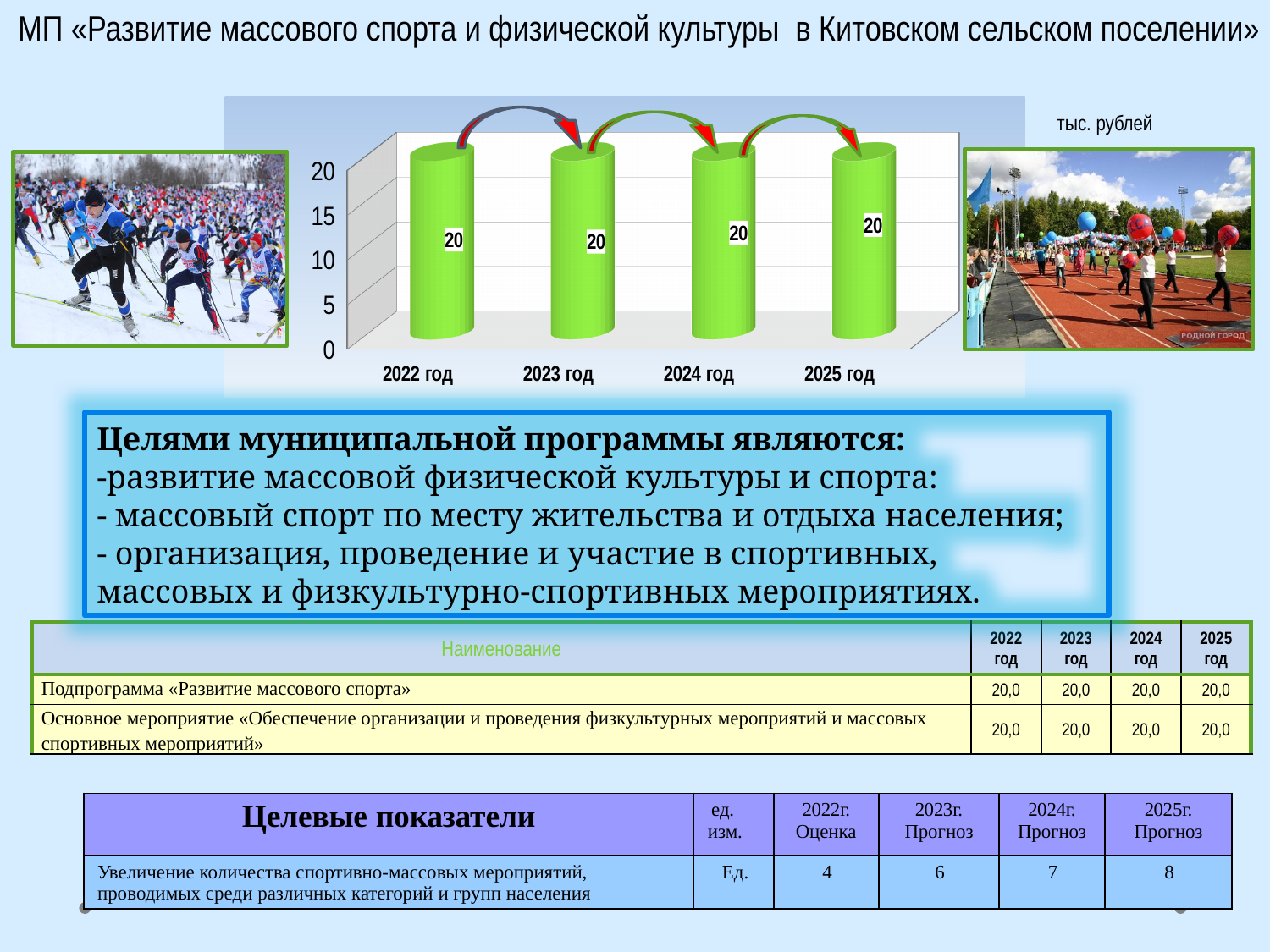
Is the value for 2024 год greater or less than 15? greater What kind of chart is shown on the slide? bar chart How many categories (years) are plotted in the chart? 4 What is the value for 2023 год in the chart? 20 What is the highest tick value shown on the vertical axis of the chart? 20 What is the value for 2024 год in the chart? 20 What unit is indicated next to the chart? тыс. рублей What is the value for 2022 год in the chart? 20 What is the value for 2025 год in the chart? 20 What is the difference between the values for 2025 год and 2022 год? 0 Do the values rise, fall or stay the same from 2022 год to 2025 год? stay the same